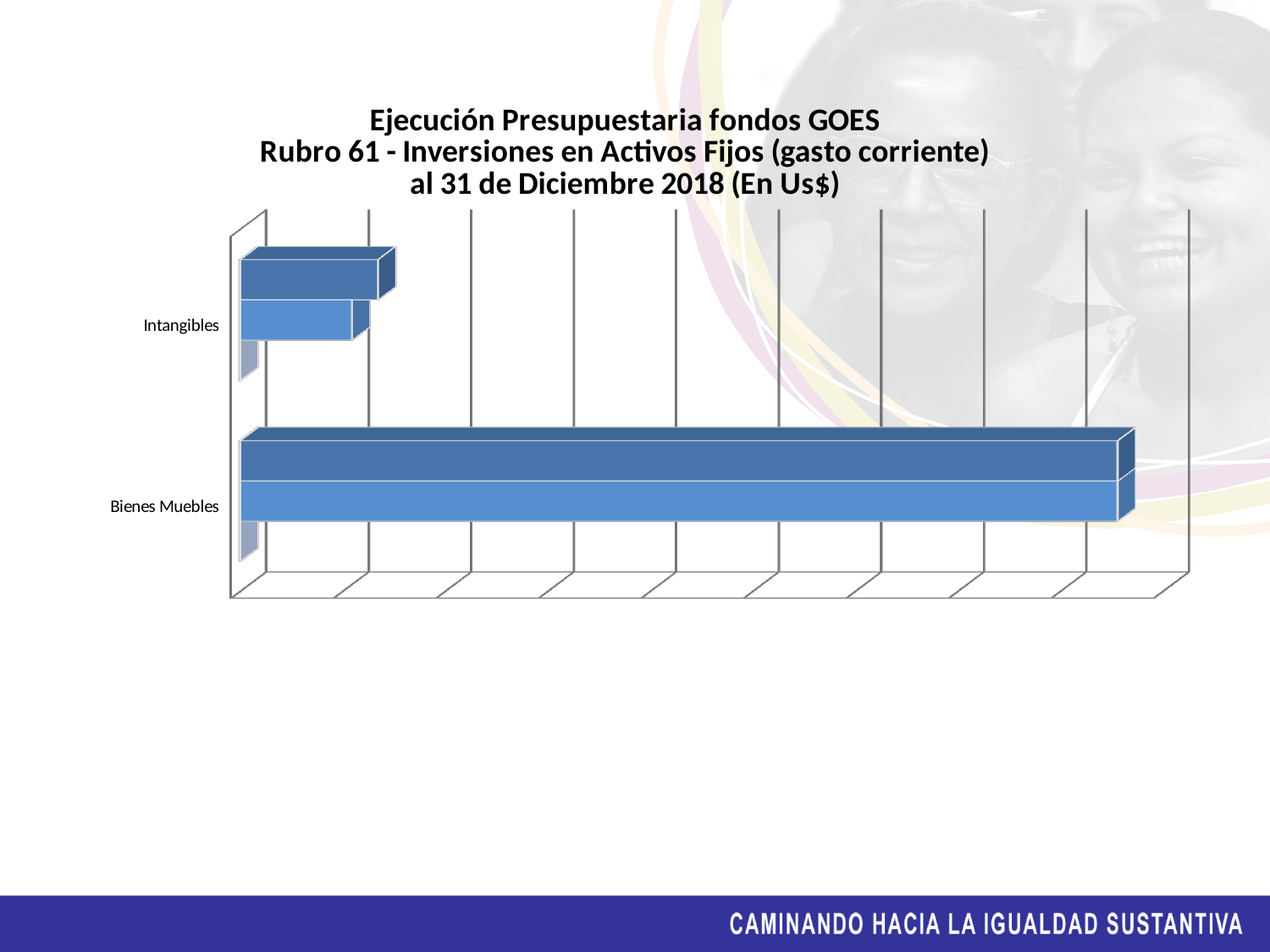
What is the first line of the chart title? Ejecución Presupuestaria fondos GOES Which category has the longest bars in the chart? Bienes Muebles What kind of chart is shown on the slide? bar chart Which category label appears at the top of the vertical axis? Intangibles Which category has the shortest bars in the chart? Intangibles How many categories are shown on the vertical axis of the chart? 2 Which category has larger values, Intangibles or Bienes Muebles? Bienes Muebles